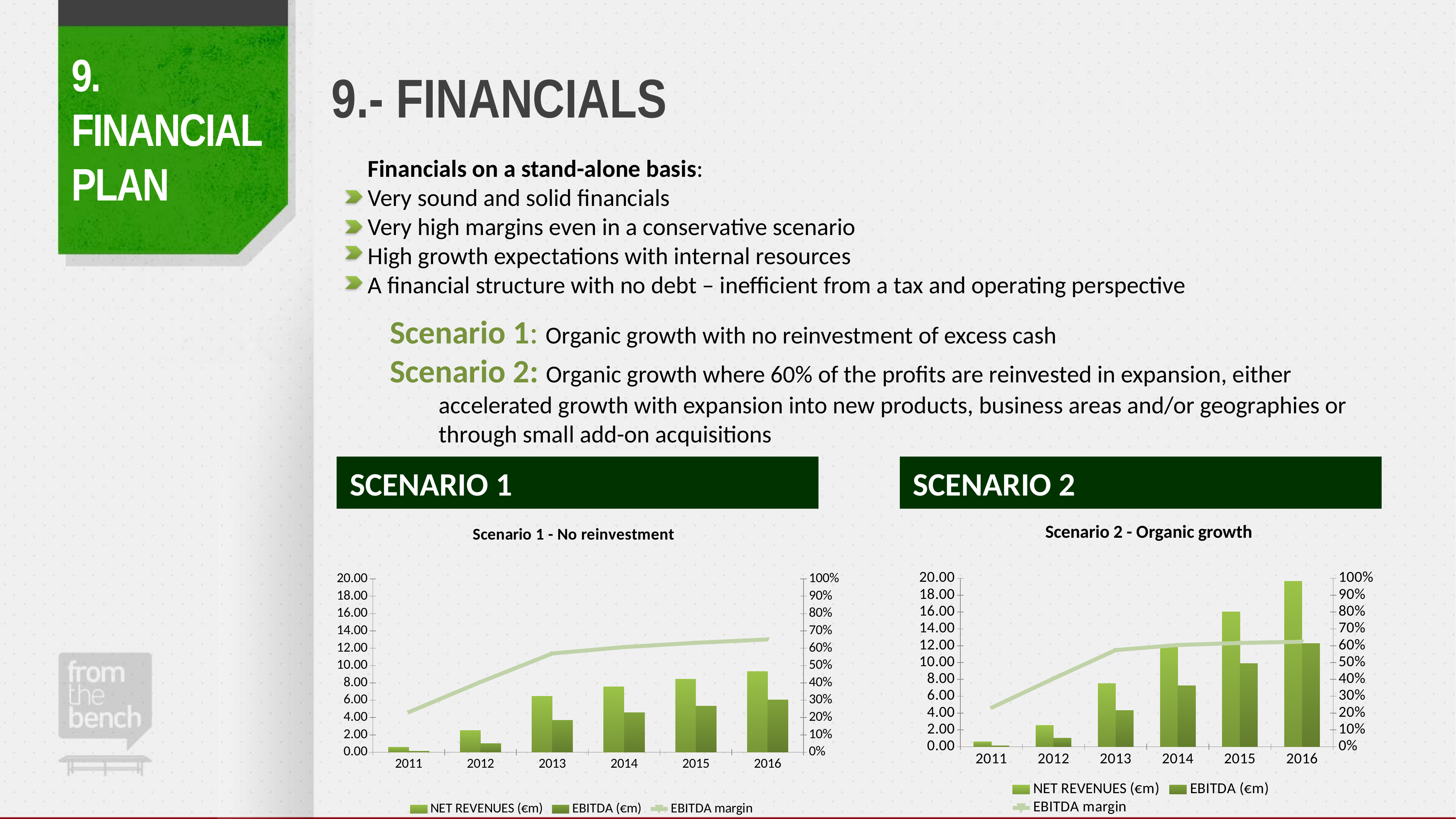
On the Scenario 1 - No reinvestment chart, how many years are shown on the x axis? 6 What kind of chart is the Scenario 2 - Organic growth chart? combination bar and line chart What is the title of the chart on the left side of the slide? Scenario 1 - No reinvestment On the Scenario 2 - Organic growth chart, is the EBITDA (€m) value for 2016 greater or less than 10.00? greater On the Scenario 1 - No reinvestment chart, is the NET REVENUES (€m) value for 2016 greater or less than 8.00? greater On the Scenario 1 - No reinvestment chart, is the EBITDA (€m) value for 2012 greater or less than 2.00? less On the Scenario 2 - Organic growth chart, how many series does the legend list? 3 On the Scenario 1 - No reinvestment chart, do NET REVENUES (€m) rise or fall from 2011 to 2016? rise On the Scenario 2 - Organic growth chart, which is larger in 2016: NET REVENUES (€m) or EBITDA (€m)? NET REVENUES (€m) On the Scenario 1 - No reinvestment chart, which year has the highest NET REVENUES (€m)? 2016 On the Scenario 2 - Organic growth chart, which year has the lowest NET REVENUES (€m)? 2011